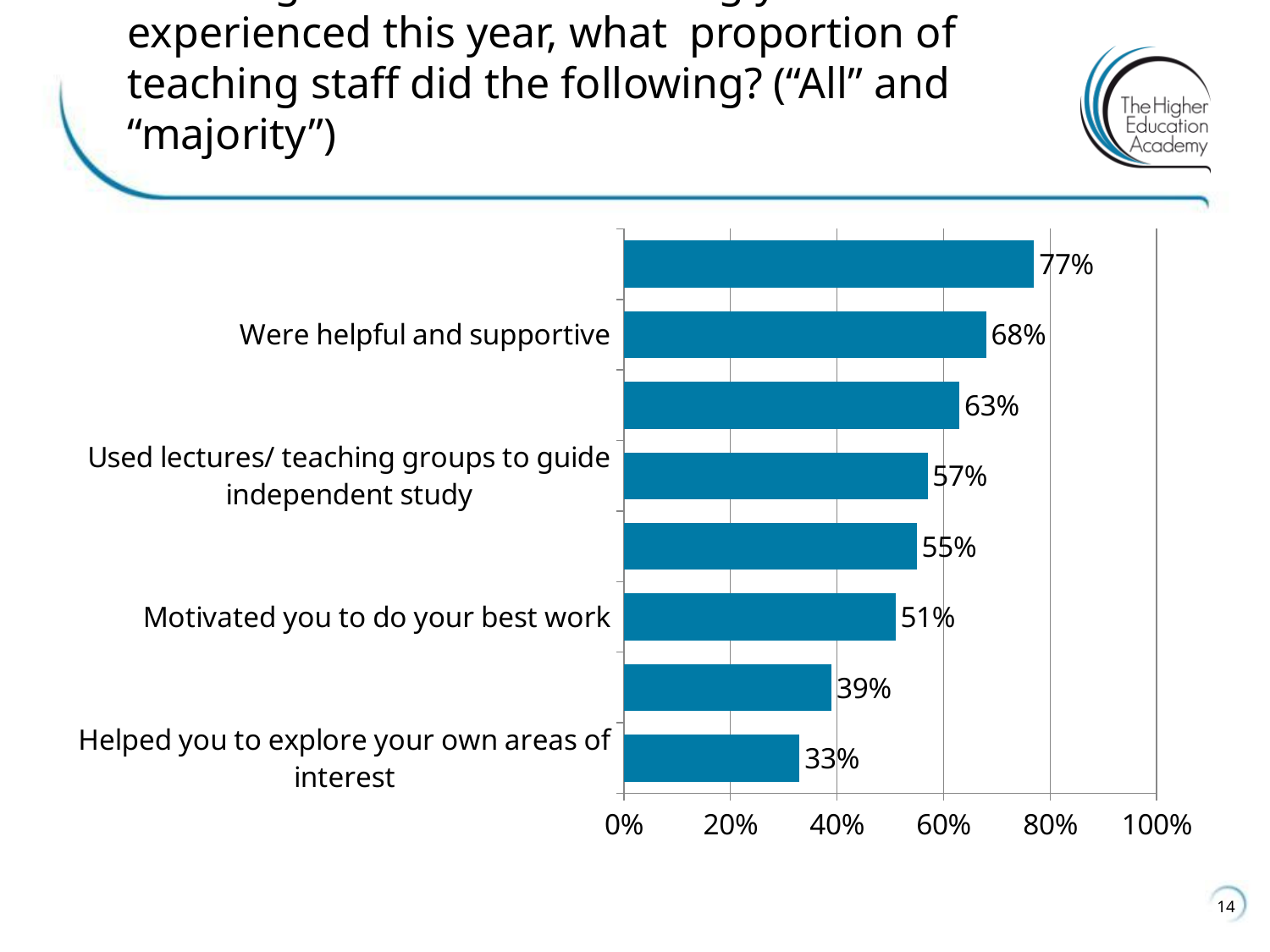
What is the highest value shown on the chart? 77% Which labelled category has the lowest value on the chart? Helped you to explore your own areas of interest What kind of chart is shown on the slide? Bar chart Is the value for 'Motivated you to do your best work' greater or less than 60%? less Which is larger: the value for 'Were helpful and supportive' or for 'Used lectures/ teaching groups to guide independent study'? Were helpful and supportive What is the difference between the values for 'Were helpful and supportive' and 'Motivated you to do your best work'? 17% What value is shown for 'Used lectures/ teaching groups to guide independent study'? 57% What percentage of teaching staff 'Were helpful and supportive'? 68% What percentage is shown for 'Motivated you to do your best work'? 51% What value is shown for 'Helped you to explore your own areas of interest'? 33% How many bars are plotted on the chart? 8 What is the difference between 'Used lectures/ teaching groups to guide independent study' and 'Helped you to explore your own areas of interest'? 24%